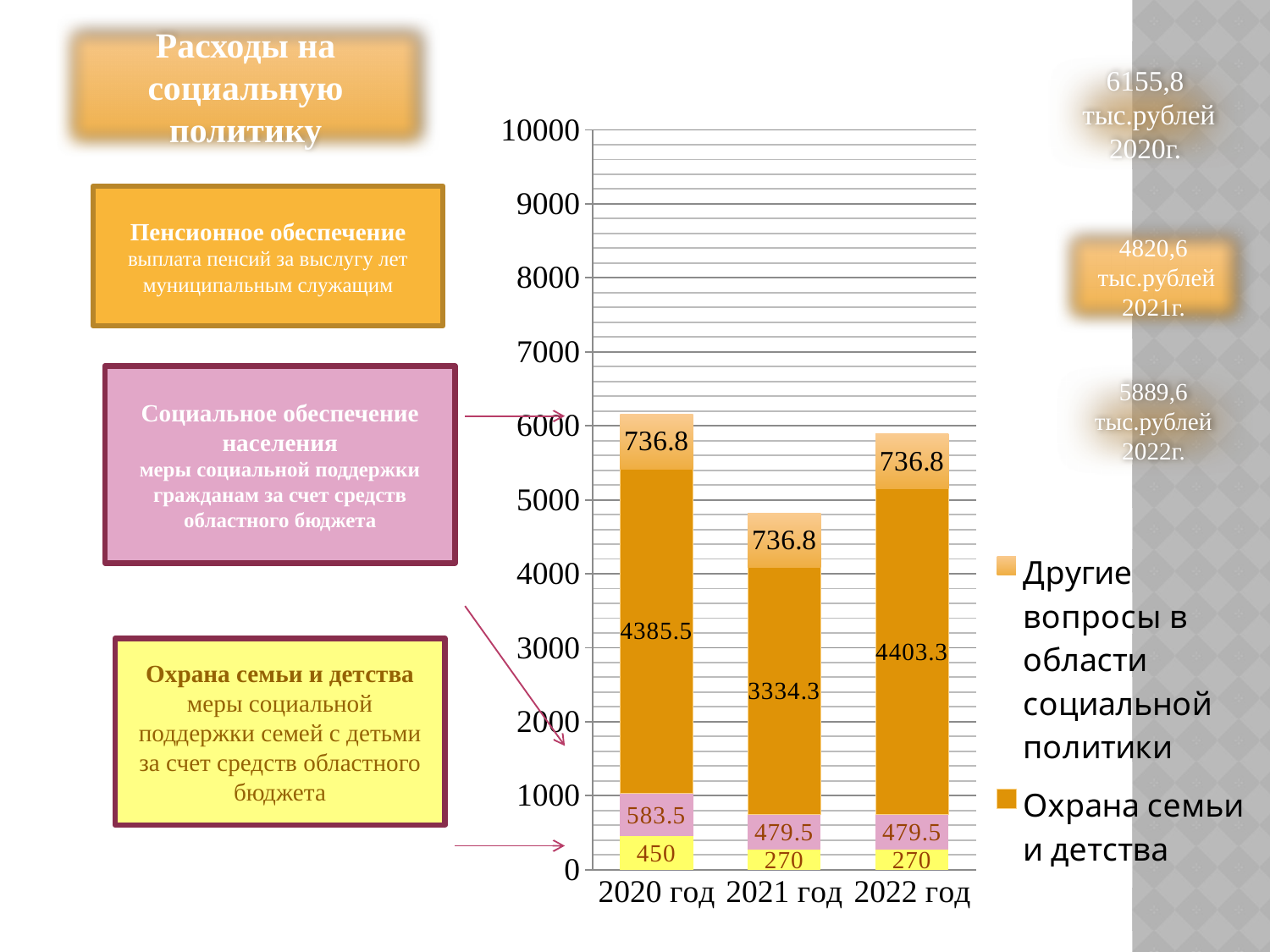
What is the difference between the Охрана семьи и детства values for 2020 год and 2021 год? 1051.2 In which year is the value for Охрана семьи и детства the highest? 2022 год How many years (categories) are shown on the x axis of the chart? 3 What is the total of the stacked bar for 2020 год? 6155.8 Is the total height of the 2021 год bar greater or less than 5000? less What kind of chart is shown on the slide? stacked bar chart What is the value for Другие вопросы в области социальной политики in 2022 год? 736.8 Which is larger, the Охрана семьи и детства value for 2020 год or for 2022 год? 2022 год What is the value for Охрана семьи и детства in 2021 год? 3334.3 What value is printed on the bottom yellow segment of the 2020 год bar? 450 In which year is the value for Охрана семьи и детства the lowest? 2021 год What is the total of the stacked bar for 2021 год? 4820.6